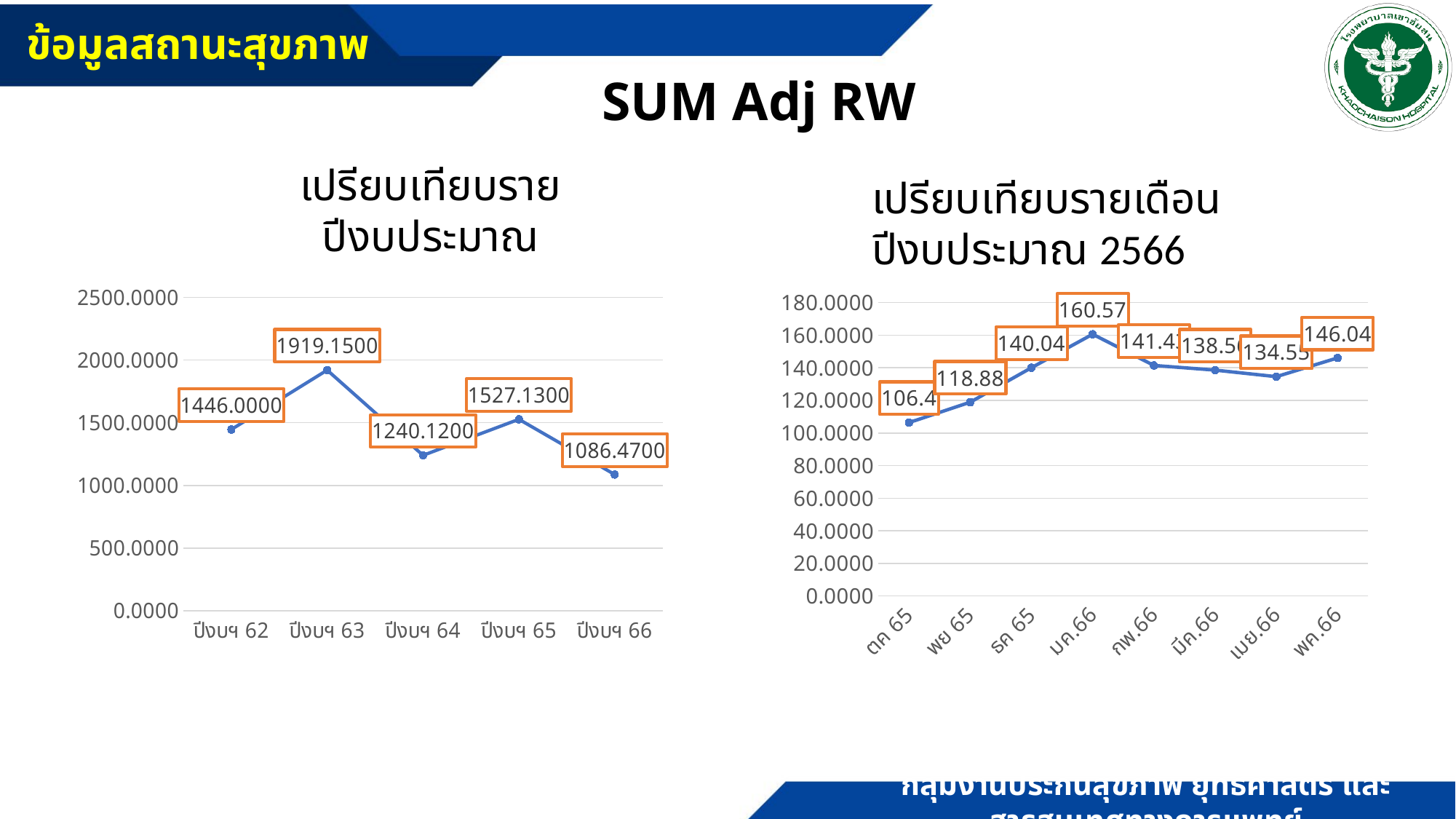
On the left chart (เปรียบเทียบรายปีงบประมาณ), which fiscal year has the highest value? ปีงบฯ 63 On the right chart (เปรียบเทียบรายเดือนปีงบประมาณ 2566), is the value for ตค 65 greater or less than 120.0000? less On the left chart (เปรียบเทียบรายปีงบประมาณ), what is the value for ปีงบฯ 63? 1919.1500 On the left chart (เปรียบเทียบรายปีงบประมาณ), how many fiscal years are plotted? 5 On the left chart (เปรียบเทียบรายปีงบประมาณ), which fiscal year has the lowest value? ปีงบฯ 66 On the right chart (เปรียบเทียบรายเดือนปีงบประมาณ 2566), which month has the highest value? มค.66 On the left chart (เปรียบเทียบรายปีงบประมาณ), what is the difference between the values for ปีงบฯ 63 and ปีงบฯ 62? 473.1500 On the right chart (เปรียบเทียบรายเดือนปีงบประมาณ 2566), what is the value for พค.66? 146.04 What kind of chart is the right chart (เปรียบเทียบรายเดือนปีงบประมาณ 2566)? line chart On the right chart (เปรียบเทียบรายเดือนปีงบประมาณ 2566), what is the value for มค.66? 160.57 On the right chart (เปรียบเทียบรายเดือนปีงบประมาณ 2566), which month has the lowest value? ตค 65 On the left chart (เปรียบเทียบรายปีงบประมาณ), what is the value for ปีงบฯ 66? 1086.4700